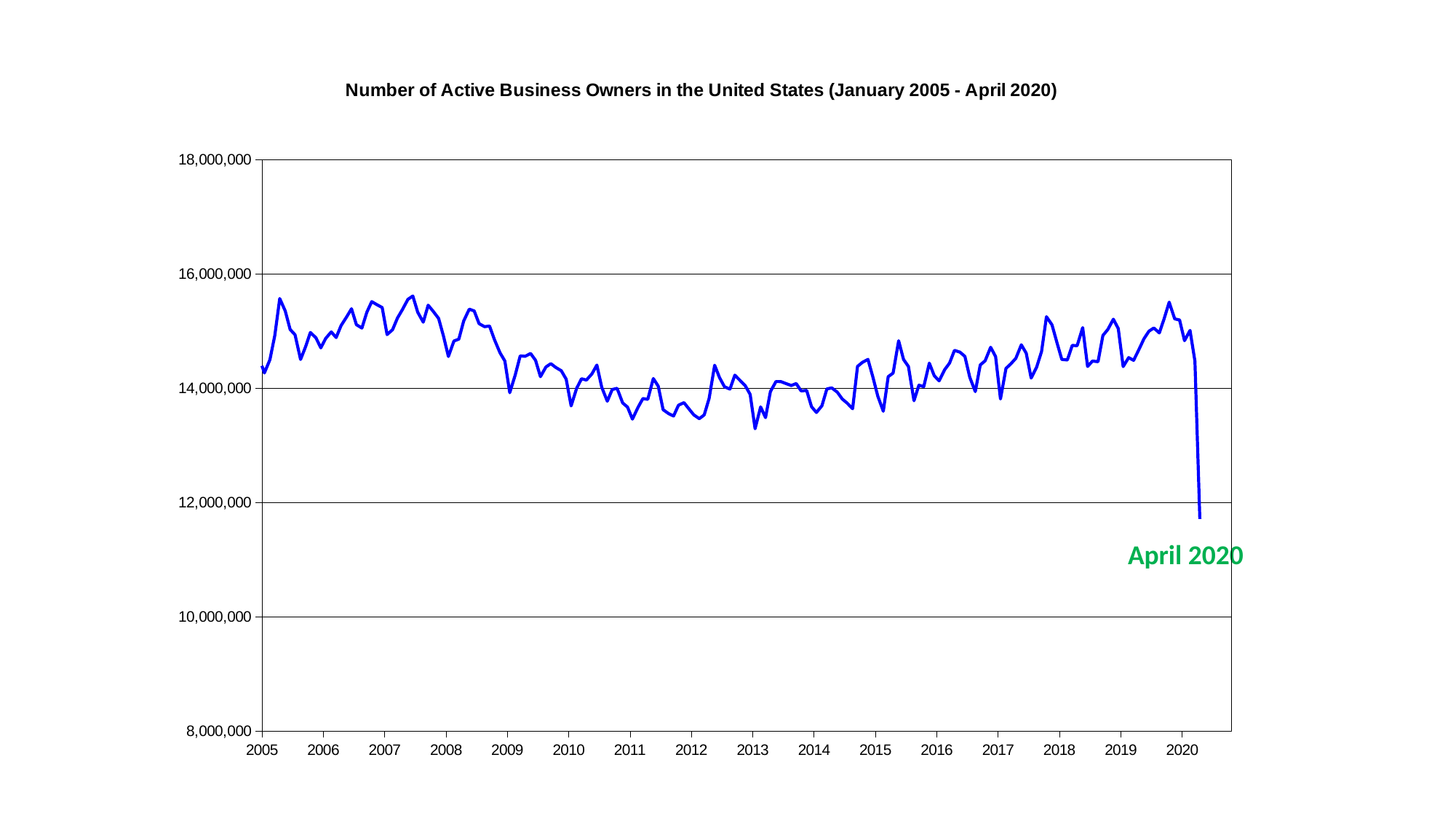
What is the title of the chart? Number of Active Business Owners in the United States (January 2005 - April 2020) Which point on the line has the lowest value? April 2020 What kind of chart is shown on the slide? Line chart Does the line generally rise or fall between 2013 and 2019? rise Does the line generally rise or fall between 2008 and 2011? fall Is the highest value reached in late 2019 greater or less than 15,000,000? greater What text is written in green next to the end of the line? April 2020 Is the value for April 2020 greater or less than 12,000,000? less How many year labels are shown on the x axis? 16 Is the lowest value reached in 2013 greater or less than 14,000,000? less